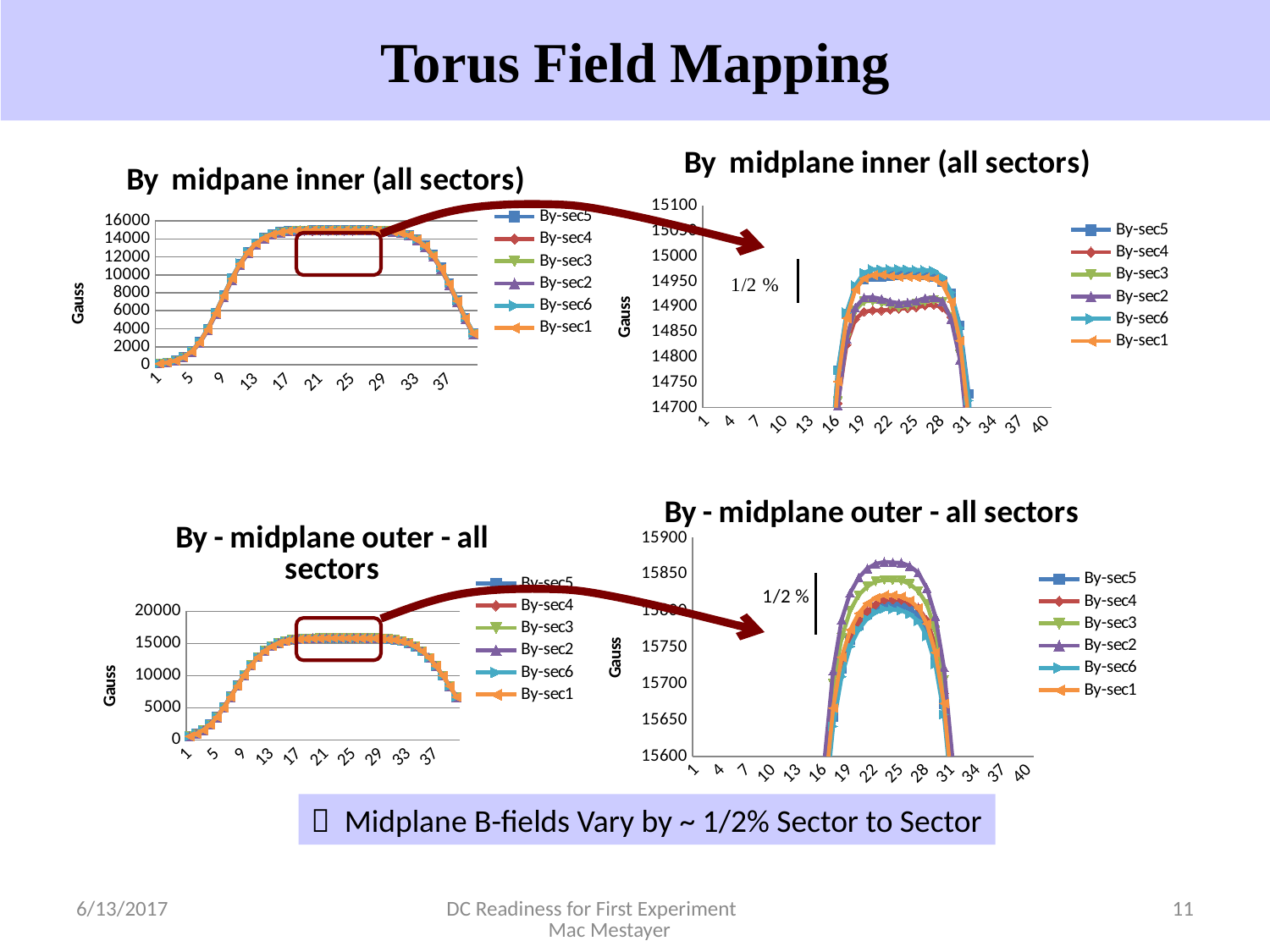
In the bottom-right zoomed chart 'By - midplane outer - all sectors', which series reaches the highest peak? By-sec2 What kind of chart is the top-left chart titled 'By midpane inner (all sectors)'? line chart In the top-right zoomed chart 'By midplane inner (all sectors)', which series has the highest values on the plateau? By-sec6 How many series does the legend list in the bottom-right chart titled 'By - midplane outer - all sectors'? 6 What is the y-axis label on the bottom-left chart 'By - midplane outer - all sectors'? Gauss How many series does the legend list in the top-right chart titled 'By midplane inner (all sectors)'? 6 What is the title of the top-right chart on the slide? By midplane inner (all sectors) In the bottom-right zoomed chart 'By - midplane outer - all sectors', which series has the lowest peak? By-sec6 In the bottom-right chart 'By - midplane outer - all sectors', is the peak value of By-sec2 greater or less than 15850? greater In the top-right chart 'By midplane inner (all sectors)', is the plateau value of By-sec6 greater or less than 14950? greater In the top-left chart 'By midpane inner (all sectors)', are the plateau values around x = 21 to 29 greater or less than 14000? greater In the top-left chart 'By midpane inner (all sectors)', do the values rise or fall from x = 1 to x = 17? rise